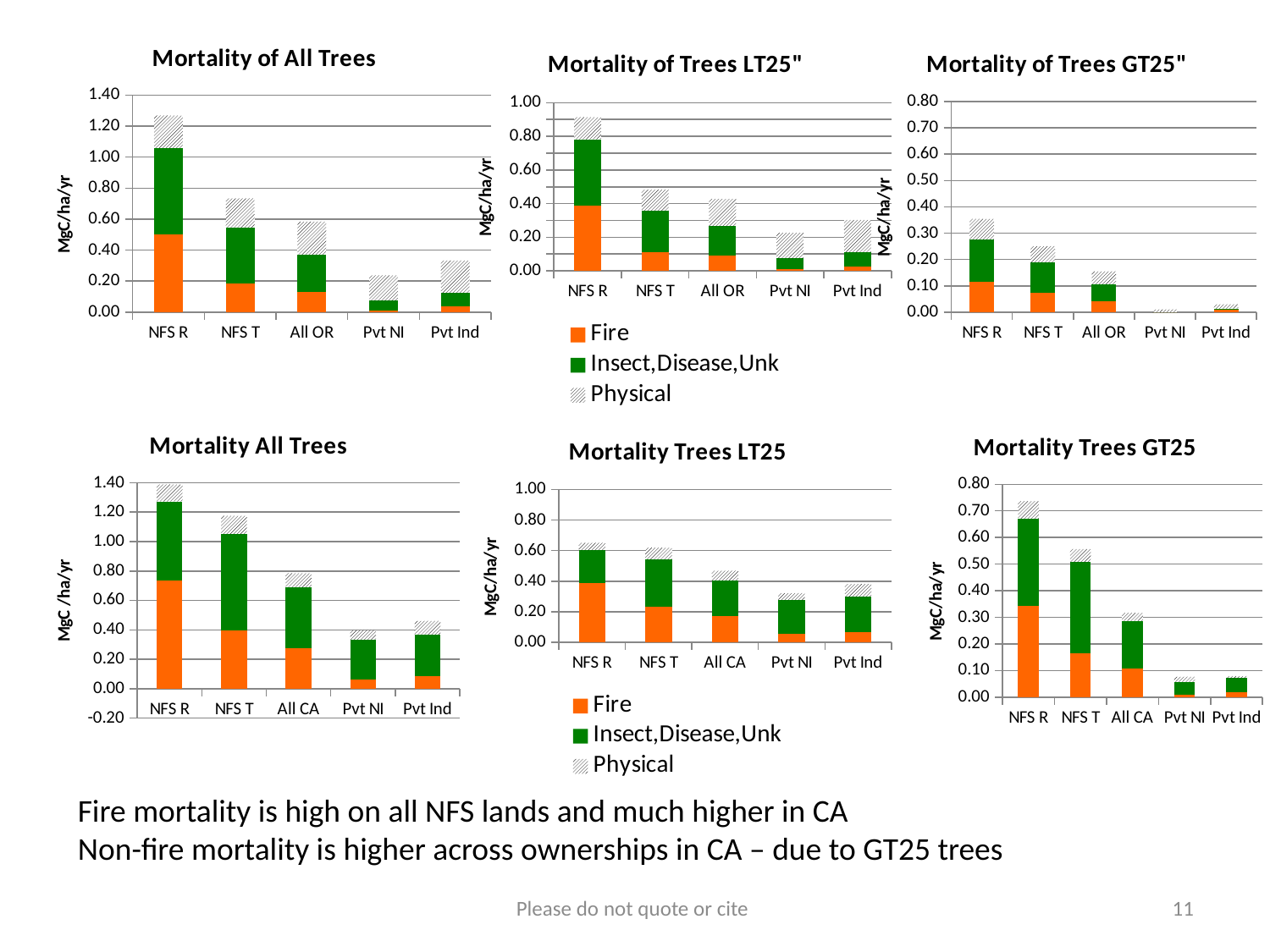
In "Mortality of All Trees" (top left), is the total bar height for NFS R greater or less than 1.00? greater In "Mortality Trees GT25" (bottom right), is the total bar height for All CA greater or less than 0.40? less In "Mortality All Trees" (bottom left), is the total bar height for NFS T greater or less than 1.00? greater In "Mortality of Trees GT25"" (top right), which category has the lowest total mortality? Pvt NI In "Mortality of All Trees" (top left), which category has the tallest bar? NFS R What kind of chart is "Mortality of All Trees" (top left)? Stacked bar chart In "Mortality Trees GT25" (bottom right), which has the taller bar, NFS R or NFS T? NFS R How many series does the legend under "Mortality of Trees LT25"" list? 3 How many categories are shown on the x axis of "Mortality of All Trees" (top left)? 5 What are the three legend entries shown under "Mortality Trees LT25" (bottom middle)? Fire; Insect,Disease,Unk; Physical In "Mortality of All Trees" (top left), which category has the shortest bar? Pvt NI